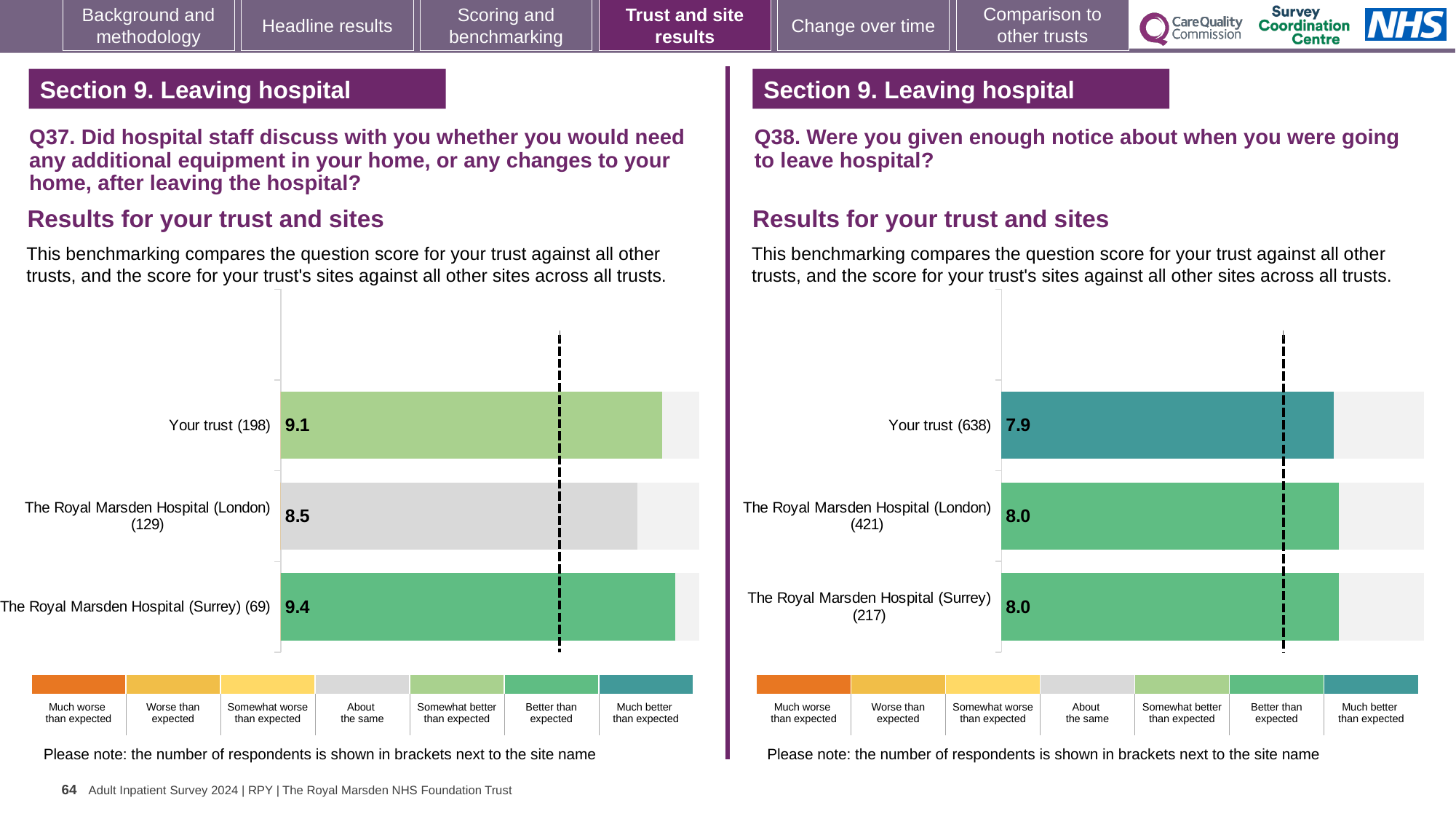
On the Q38 chart (right), what is the score for The Royal Marsden Hospital (Surrey)? 8.0 On the Q38 chart (right), which benchmark category does the colour of the Your trust bar represent? Much better than expected On the Q37 chart (left), which site or trust has the lowest score? The Royal Marsden Hospital (London) On the Q38 chart (right), how many respondents are shown for Your trust? 638 What kind of chart is used on the Q37 chart (left)? Bar chart On the Q37 chart (left), what is the difference between the scores for The Royal Marsden Hospital (Surrey) and The Royal Marsden Hospital (London)? 0.9 On the Q37 chart (left), which site or trust has the highest score? The Royal Marsden Hospital (Surrey) On the Q37 chart (left), which benchmark category does the colour of the Your trust bar represent? Somewhat better than expected On the Q37 chart (left), what is the score for The Royal Marsden Hospital (London)? 8.5 On the Q37 chart (left), what is the score for Your trust? 9.1 On the Q38 chart (right), what is the score for Your trust? 7.9 On the Q38 chart (right), how many bars are plotted? 3